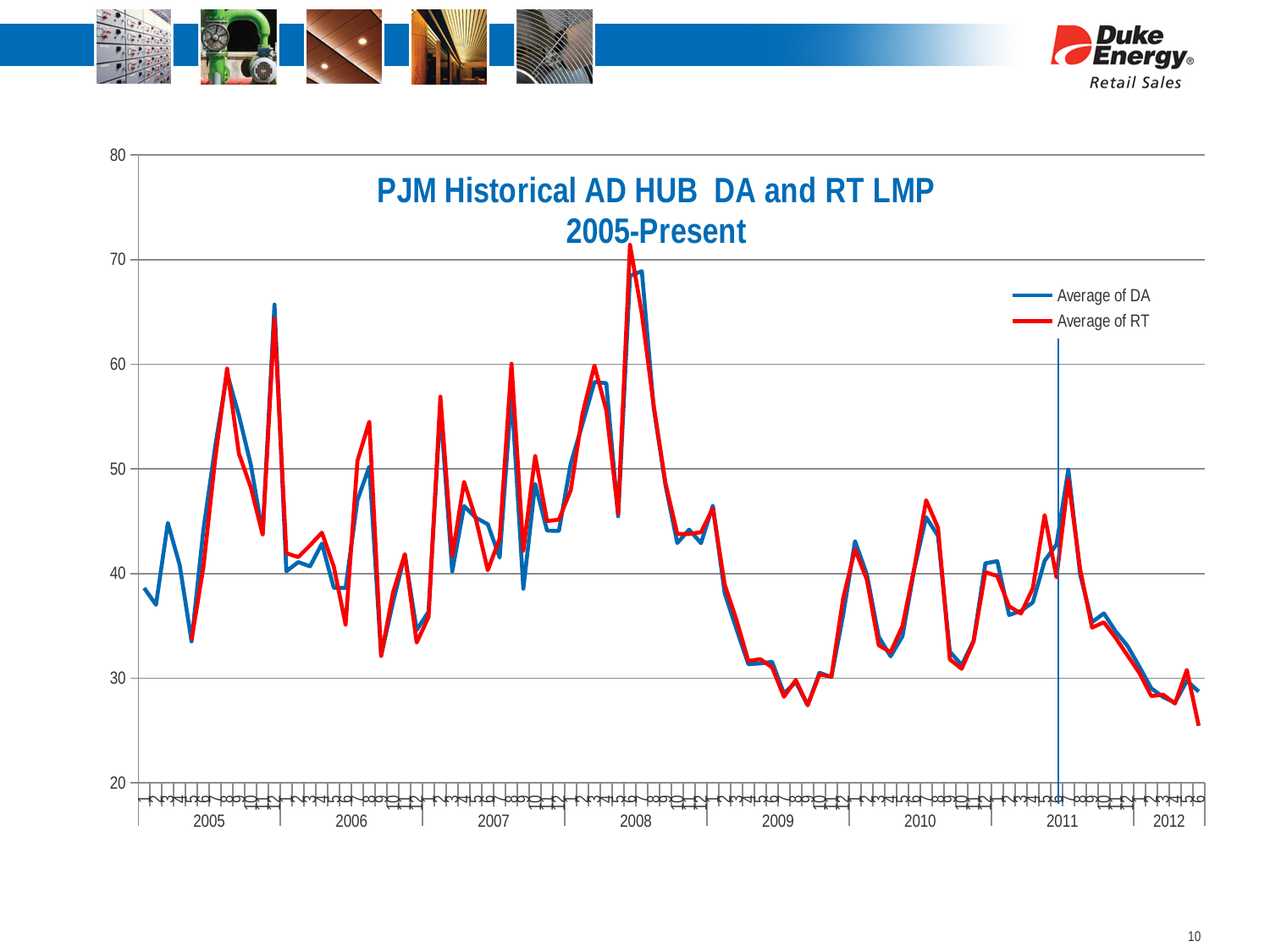
How many series does the legend list? 2 How many years are labelled along the x axis? 8 Is the highest peak of the Average of DA line in 2005 greater or less than 60? greater What is the title of the chart? PJM Historical AD HUB DA and RT LMP 2005-Present Which colour is used for the Average of RT series? red Do the values generally rise or fall from the 2008 peak through 2009? fall Is the value of the Average of RT line at the last point in 2012 greater or less than 30? less Is the lowest value of the Average of RT line in 2009 greater or less than 30? less What kind of chart is shown on the slide? line chart In which year do the lines reach their highest peak? 2008 Which year contains the lowest point of the Average of RT line? 2012